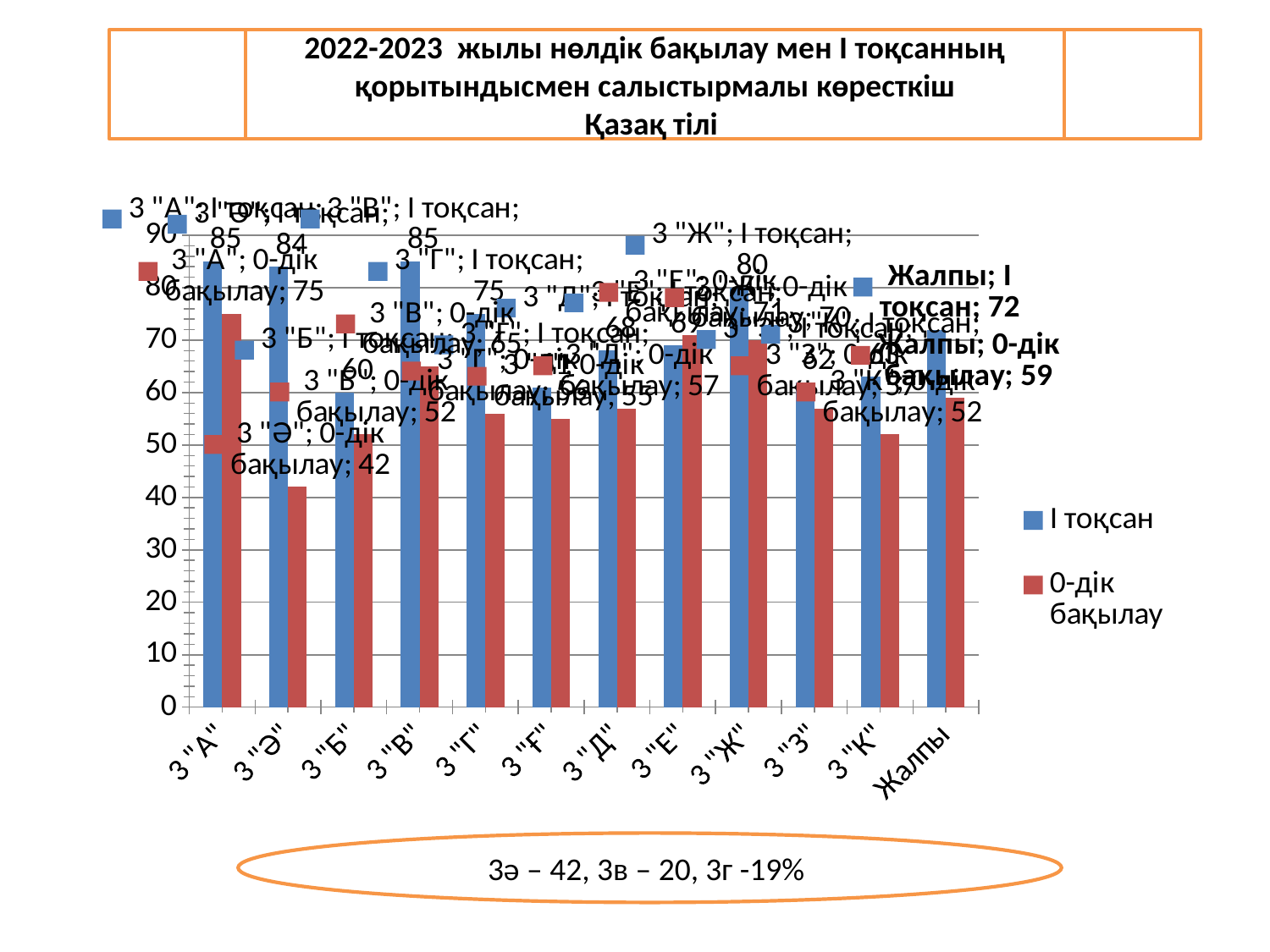
What is the difference between the І тоқсан and 0-дік бақылау values for 3 "Ә"? 42 What is the 0-дік бақылау value for 3 "Ә"? 42 Which category has the lowest 0-дік бақылау value? 3 "Ә" How many series does the legend list? 2 What is the І тоқсан value for Жалпы? 72 What is the 0-дік бақылау value for Жалпы? 59 What is the І тоқсан value for 3 "А"? 85 What kind of chart is shown on the slide? bar chart What is the difference between the І тоқсан and 0-дік бақылау values for Жалпы? 13 For 3 "Ә", which is larger: the І тоқсан value or the 0-дік бақылау value? І тоқсан Is the І тоқсан value for 3 "З" greater or less than 70? less How many categories are shown on the x axis? 12